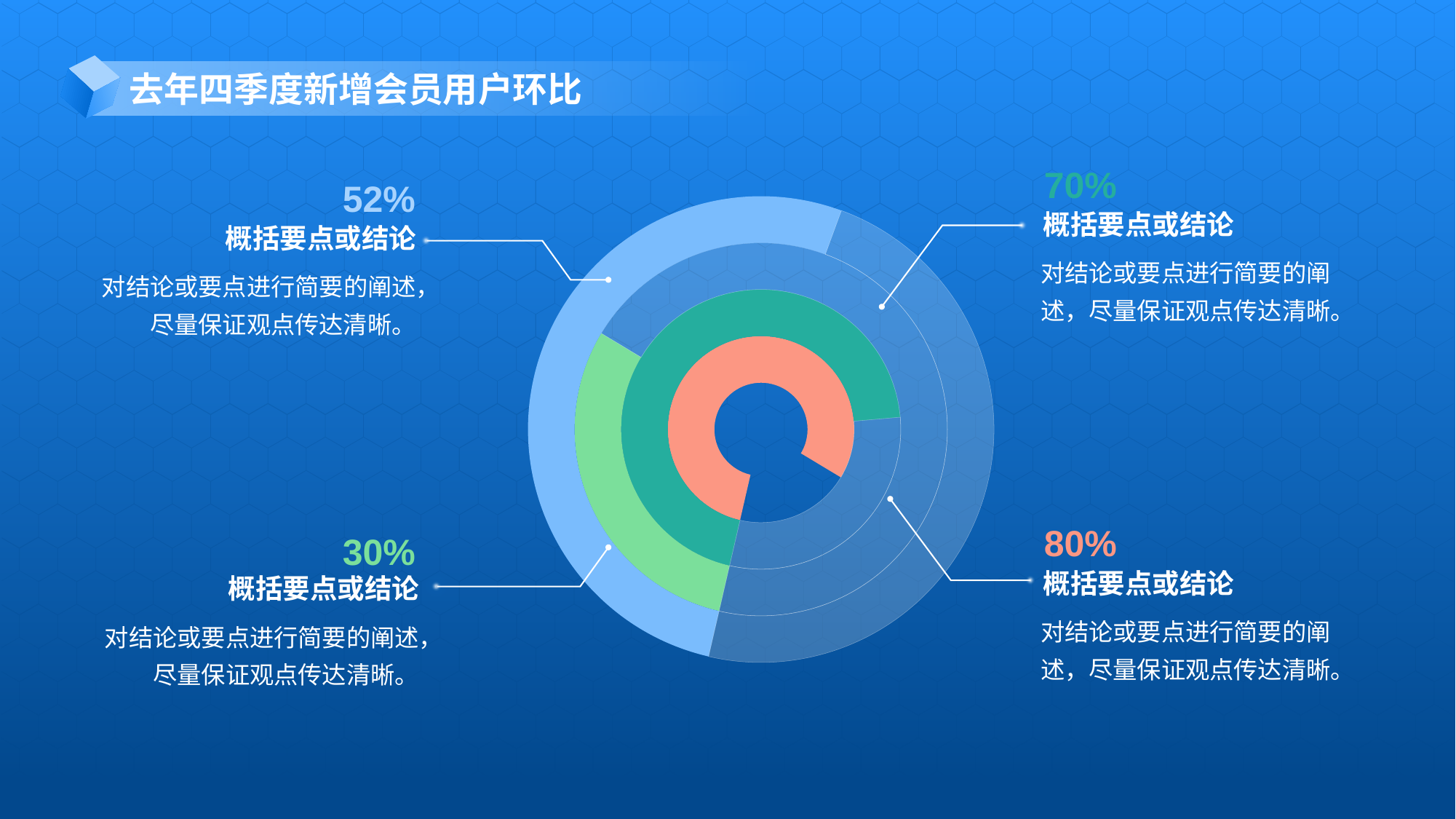
What kind of chart is shown on the slide? Donut (ring) chart What is the title of the chart on the slide? 去年四季度新增会员用户环比 How many percentage values are labelled on the chart? 4 What is the difference between the highest value (80%) and the lowest value (30%)? 50% Which labelled value on the chart is the highest? 80% What value is shown for the light blue segment (top-left callout)? 52% What value is shown for the teal segment (top-right callout)? 70% What value is shown for the salmon/orange segment (bottom-right callout)? 80% Which is larger, the value for the light blue segment or the value for the teal segment? The teal segment (70%) Which labelled value on the chart is the lowest? 30% What is the difference between the teal segment's value and the light blue segment's value? 18% What value is shown for the green segment (bottom-left callout)? 30%